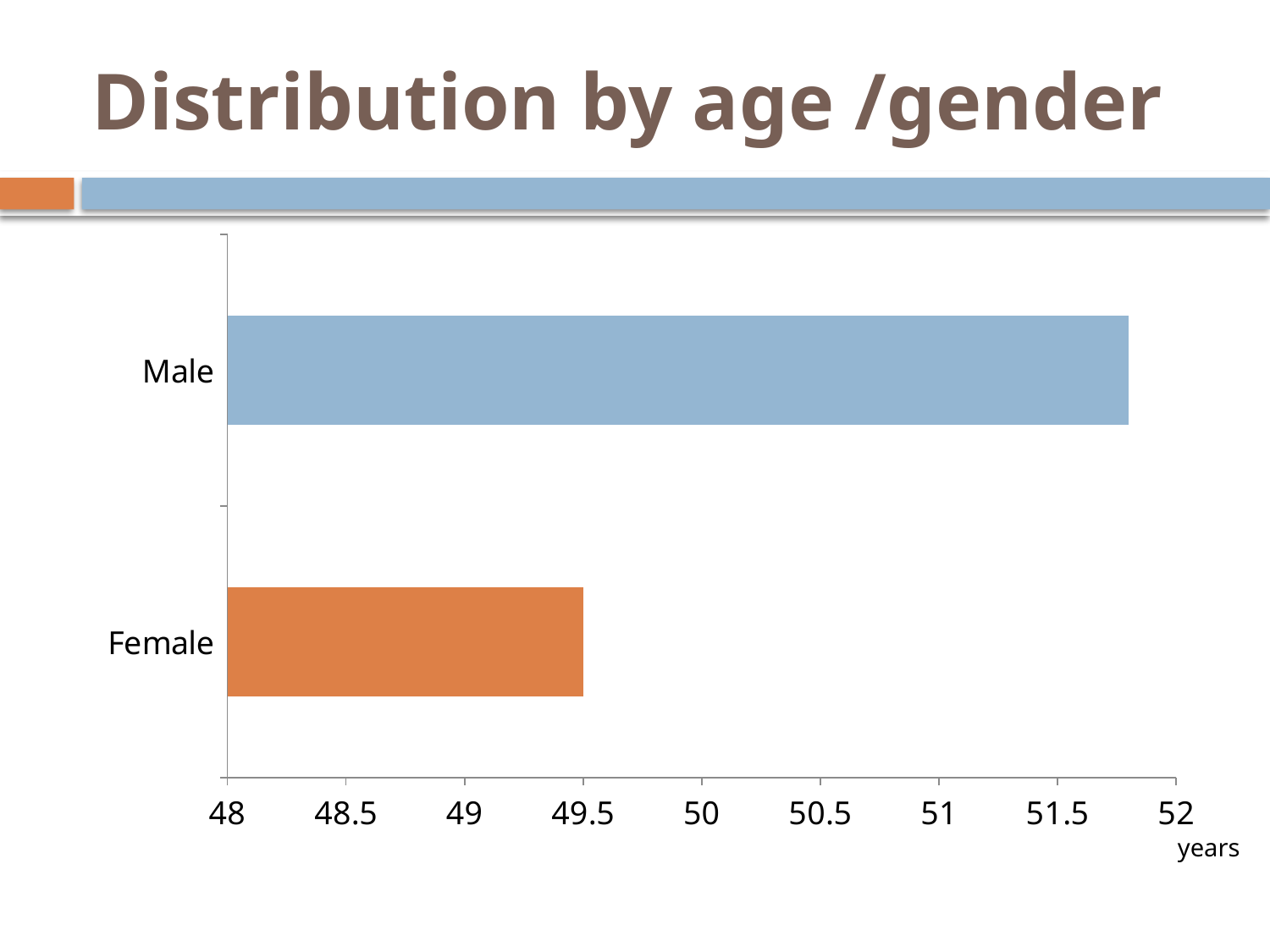
Which category has the highest value? Male Which category has the lowest value? Female What kind of chart is shown on the slide? bar chart Is the value for Female greater or less than 50? less Is the value for Male greater or less than 51.5? greater Is the value for Male greater or less than 52? less Which is larger, the value for Male or the value for Female? Male How many categories are plotted in the chart? 2 What is the value for Female? 49.5 What is the maximum value shown on the x axis? 52 What unit label is shown on the x axis of the chart? years What is the title of the slide containing the chart? Distribution by age /gender